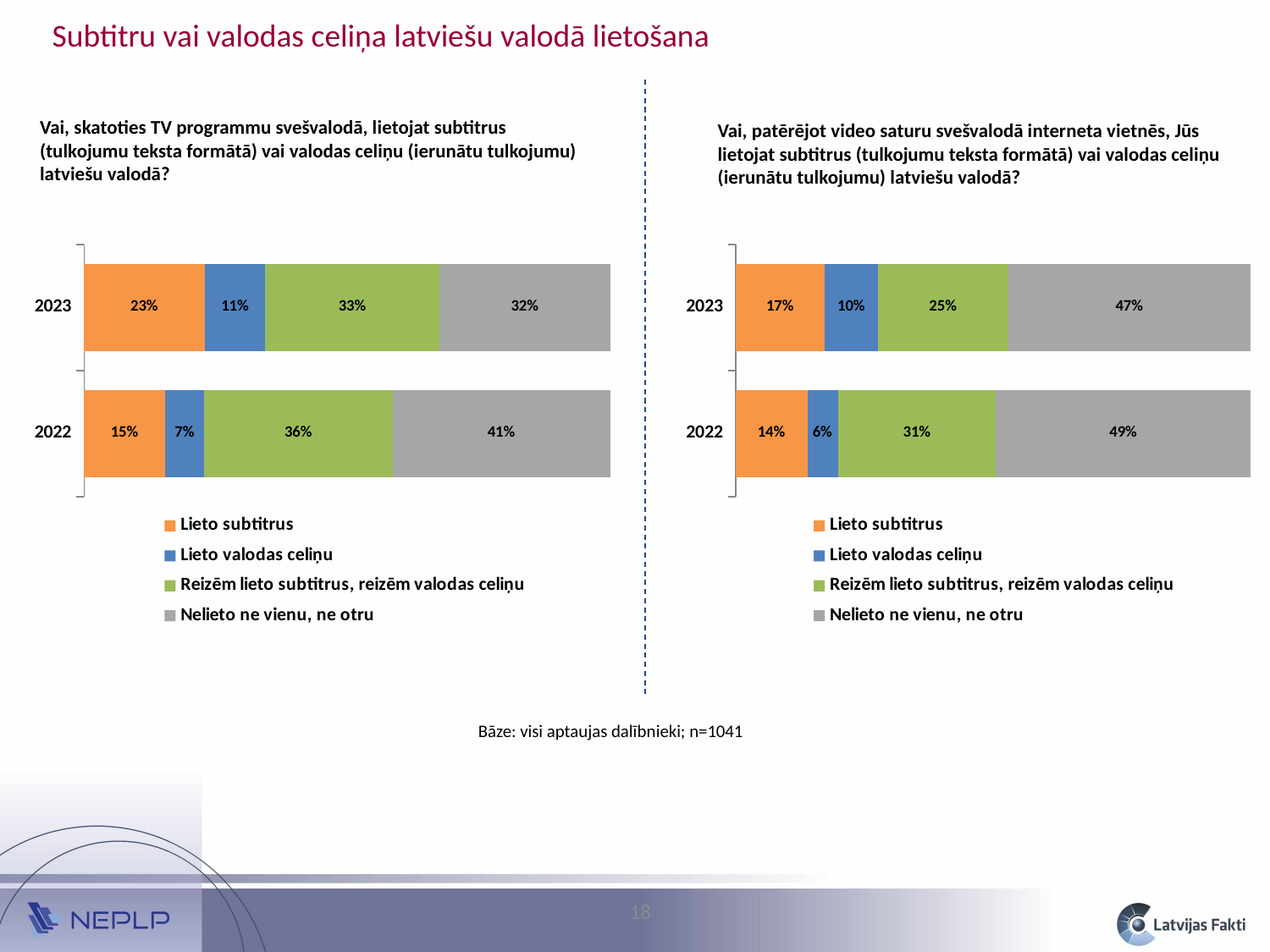
In the left chart (TV programmes), which segment is the largest in the 2022 bar? Nelieto ne vienu, ne otru In the left chart (TV programmes), what is the difference between the "Lieto subtitrus" values for 2023 and 2022? 8% In the right chart (internet video), what is the value for "Reizēm lieto subtitrus, reizēm valodas celiņu" in 2023? 25% In the right chart (internet video), which segment is the smallest in the 2022 bar? Lieto valodas celiņu How many series does the legend of the left chart list? 4 In the left chart (TV programmes), what is the value for "Lieto subtitrus" in 2023? 23% In the left chart (TV programmes), what is the value for "Lieto valodas celiņu" in 2022? 7% In the right chart (internet video), which is larger: "Nelieto ne vienu, ne otru" in 2023 or in 2022? 2022 How many years (categories) are shown in the right chart? 2 In the right chart (internet video), what is the total of the 2023 bar? 99% In the right chart (internet video), what is the value for "Nelieto ne vienu, ne otru" in 2022? 49% What kind of chart is the left chart? Stacked bar chart